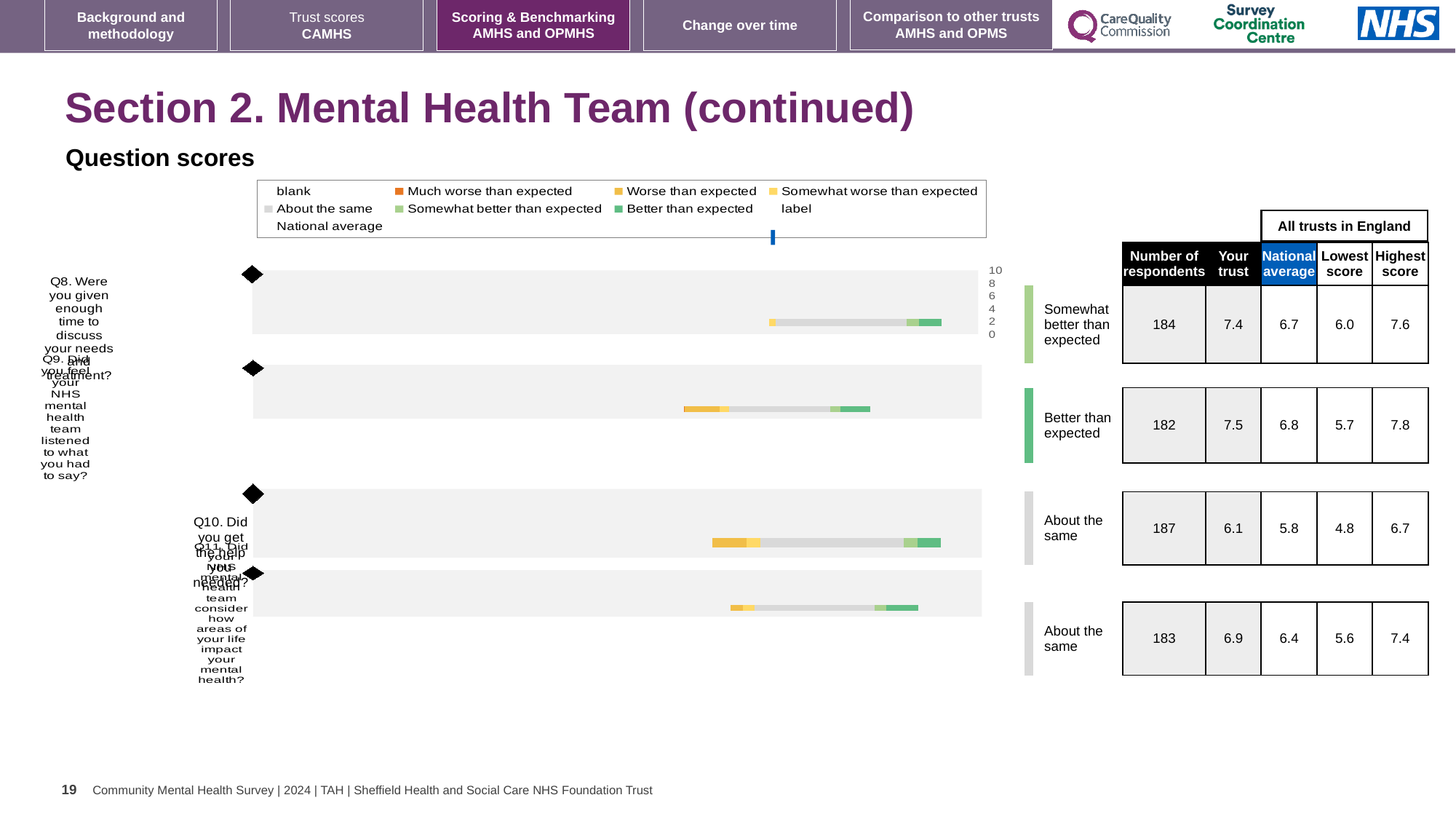
Which question has the lowest 'Your trust' score in the table beside the chart? Q10 How many survey questions (bars) are plotted in the chart? 4 What benchmark category is shown for Q9 next to the chart? Better than expected Which legend entry is shown in dark green in the chart's legend? Better than expected In the table beside the chart, what is the 'Your trust' score for Q8 (Were you given enough time to discuss your needs and treatment?)? 7.4 In the table beside the chart, what is the number of respondents for Q10 (Did you get the help you needed?)? 187 What kind of chart is shown on the slide? bar chart What is the difference between the 'Your trust' score and the national average for Q8 in the table beside the chart? 0.7 Which question has the highest 'Your trust' score in the table beside the chart? Q9 Which legend entry is shown in orange in the chart's legend? Much worse than expected In the table beside the chart, what is the national average for Q9? 6.8 In the table beside the chart, what is the highest score across all trusts in England for Q11? 7.4